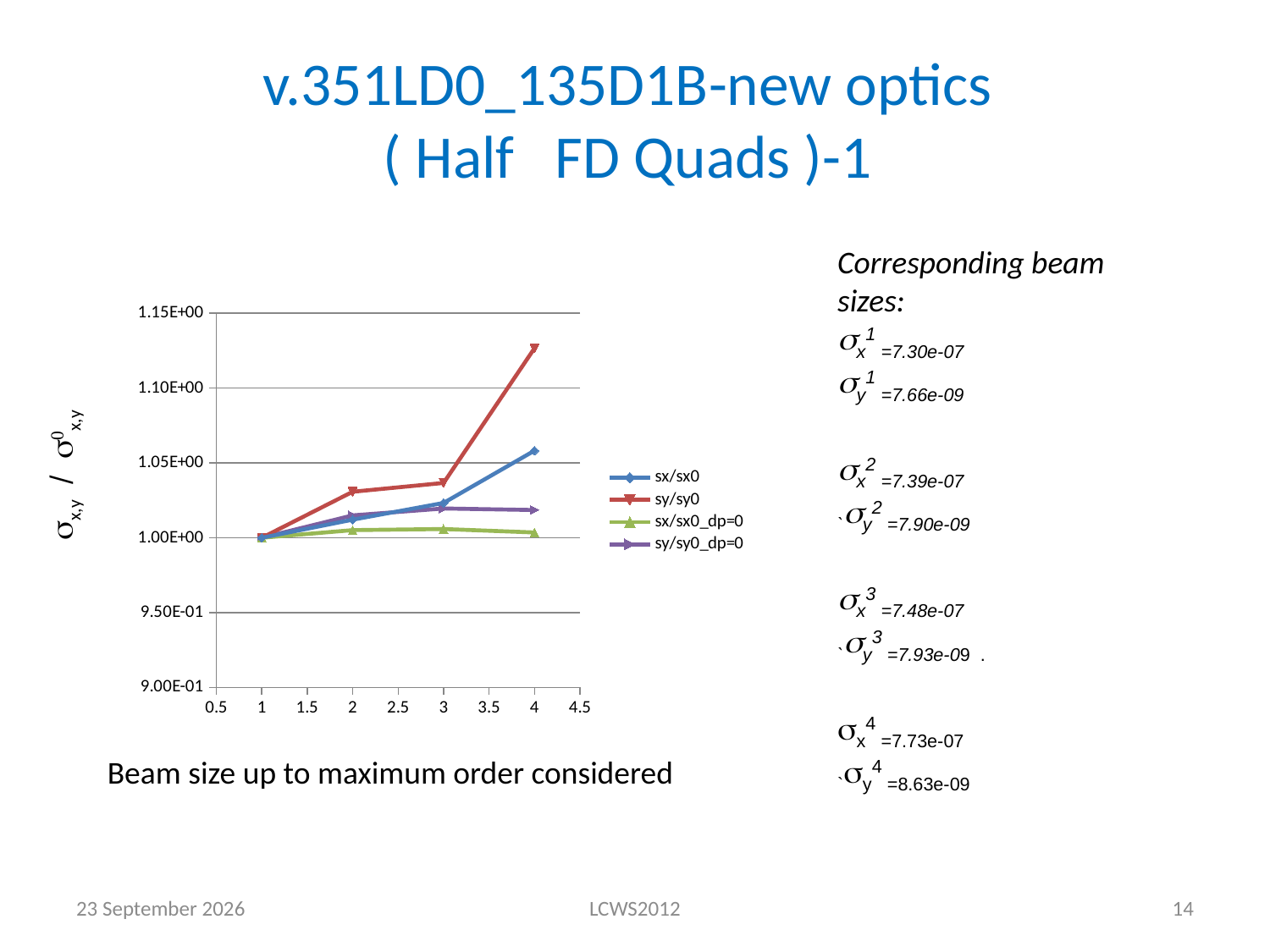
Which series has the highest value at x = 4? sy/sy0 What are the four legend entries of the chart? sx/sx0, sy/sy0, sx/sx0_dp=0, sy/sy0_dp=0 How many data points does the sy/sy0 series have? 4 Is the value of sy/sy0 at x = 4 greater or less than 1.10E+00? greater Is the value of sx/sx0 at x = 4 greater or less than 1.05E+00? greater At x = 4, which is larger: sx/sx0 or sy/sy0_dp=0? sx/sx0 Which series has the lowest value at x = 4? sx/sx0_dp=0 What is the value of sy/sy0 at x = 1? 1.00E+00 What kind of chart is shown on the slide? line chart Is the value of sy/sy0 at x = 2 greater or less than 1.05E+00? less Does the sy/sy0 series rise or fall as x increases from 1 to 4? rise How many series does the chart legend list? 4